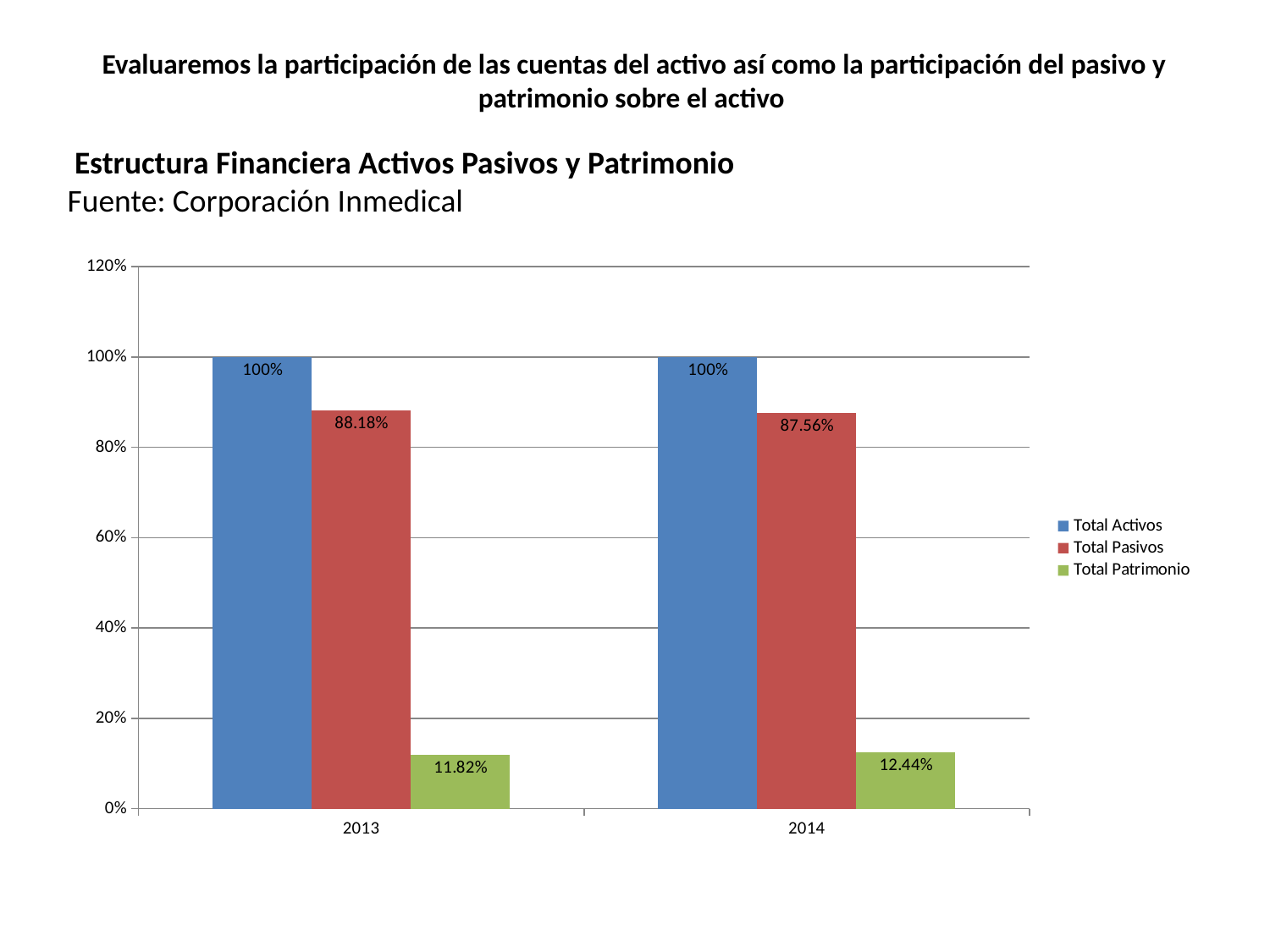
Which series has the highest value in 2014? Total Activos What is the value for Total Patrimonio in 2013? 11.82% What is the value for Total Pasivos in 2013? 88.18% What kind of chart is shown on the slide? Bar chart Is Total Patrimonio larger in 2013 or in 2014? 2014 What is the value for Total Patrimonio in 2014? 12.44% Does the value for Total Pasivos rise or fall from 2013 to 2014? Fall What is the value for Total Activos in 2014? 100% Which series has the lowest value in 2013? Total Patrimonio What is the difference between Total Pasivos in 2013 and Total Pasivos in 2014? 0.62% How many categories are shown on the x axis? 2 How many series does the legend list? 3